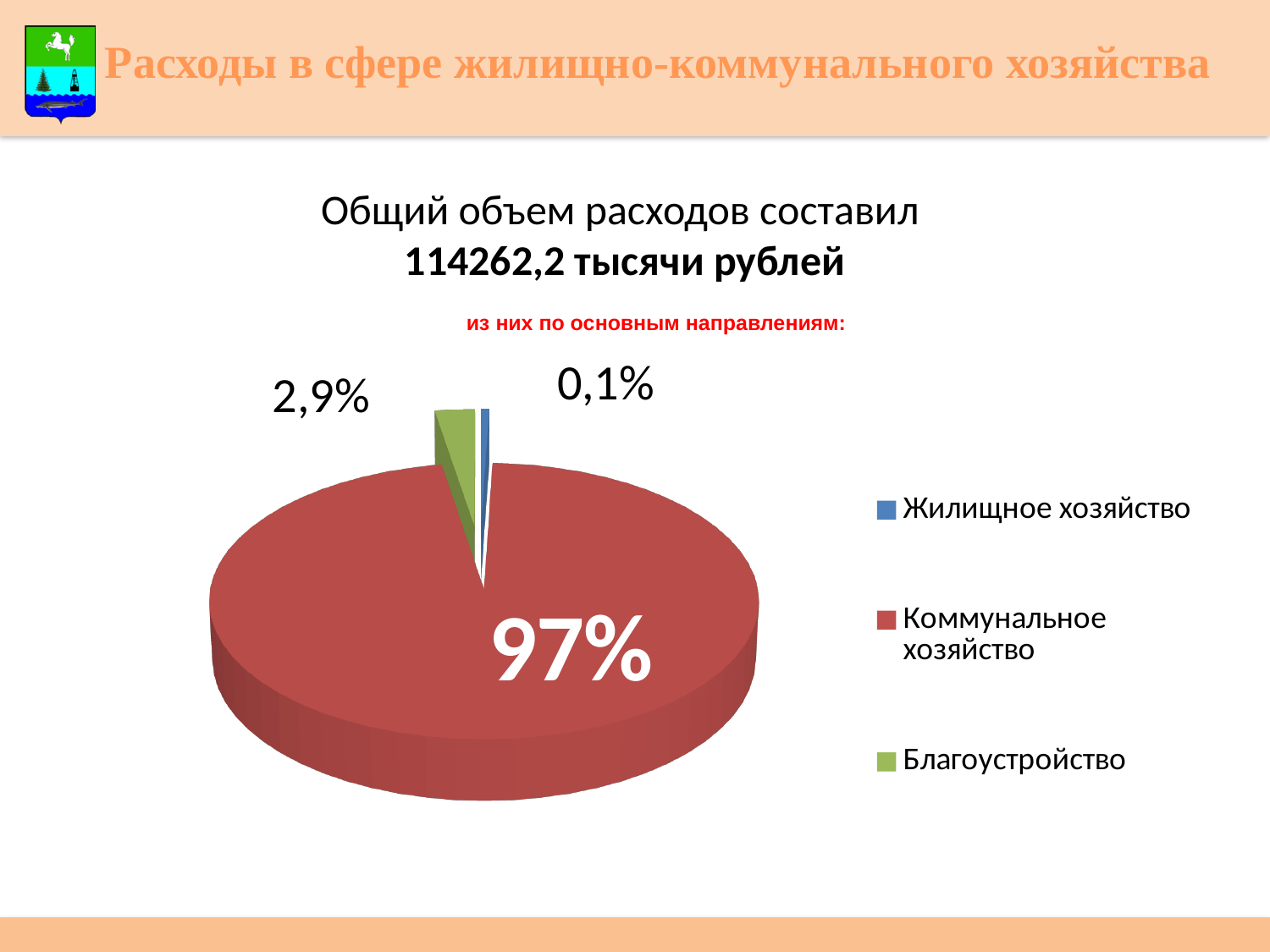
What share of the pie does Благоустройство have? 2,9% What colour is the slice for Благоустройство? Green How many categories does the legend list? 3 Which category has the largest slice of the pie? Коммунальное хозяйство What share of the pie does Коммунальное хозяйство have? 97% What kind of chart is shown on the slide? Pie chart Which is larger, the slice for Благоустройство or the slice for Жилищное хозяйство? Благоустройство Which category has the smallest slice of the pie? Жилищное хозяйство What is the difference between the shares of Благоустройство and Жилищное хозяйство? 2,8% What share of the pie does Жилищное хозяйство have? 0,1% What total volume of expenses is stated above the chart? 114262,2 тысячи рублей